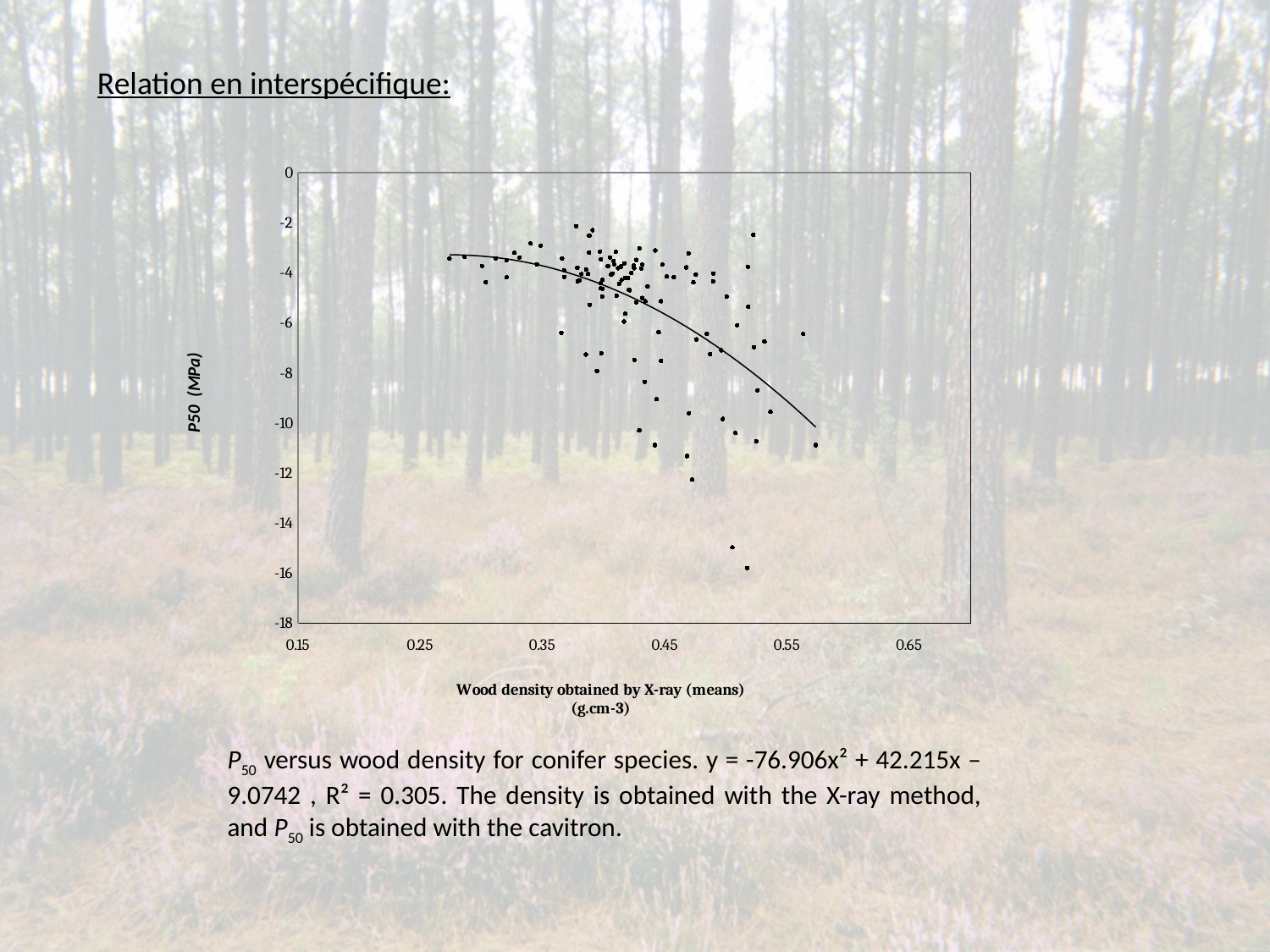
What is the label of the y axis of the chart? P50 (MPa) Is the lowest P50 point plotted on the chart greater or less than -14? less Is the highest P50 point plotted on the chart greater or less than -4? greater As wood density increases along the x axis, do the P50 values generally rise or fall? Fall Are all the plotted points located at wood densities greater or less than 0.65? less What kind of chart is shown on the slide? Scatter plot What is the label of the x axis of the chart? Wood density obtained by X-ray (means) (g.cm-3)